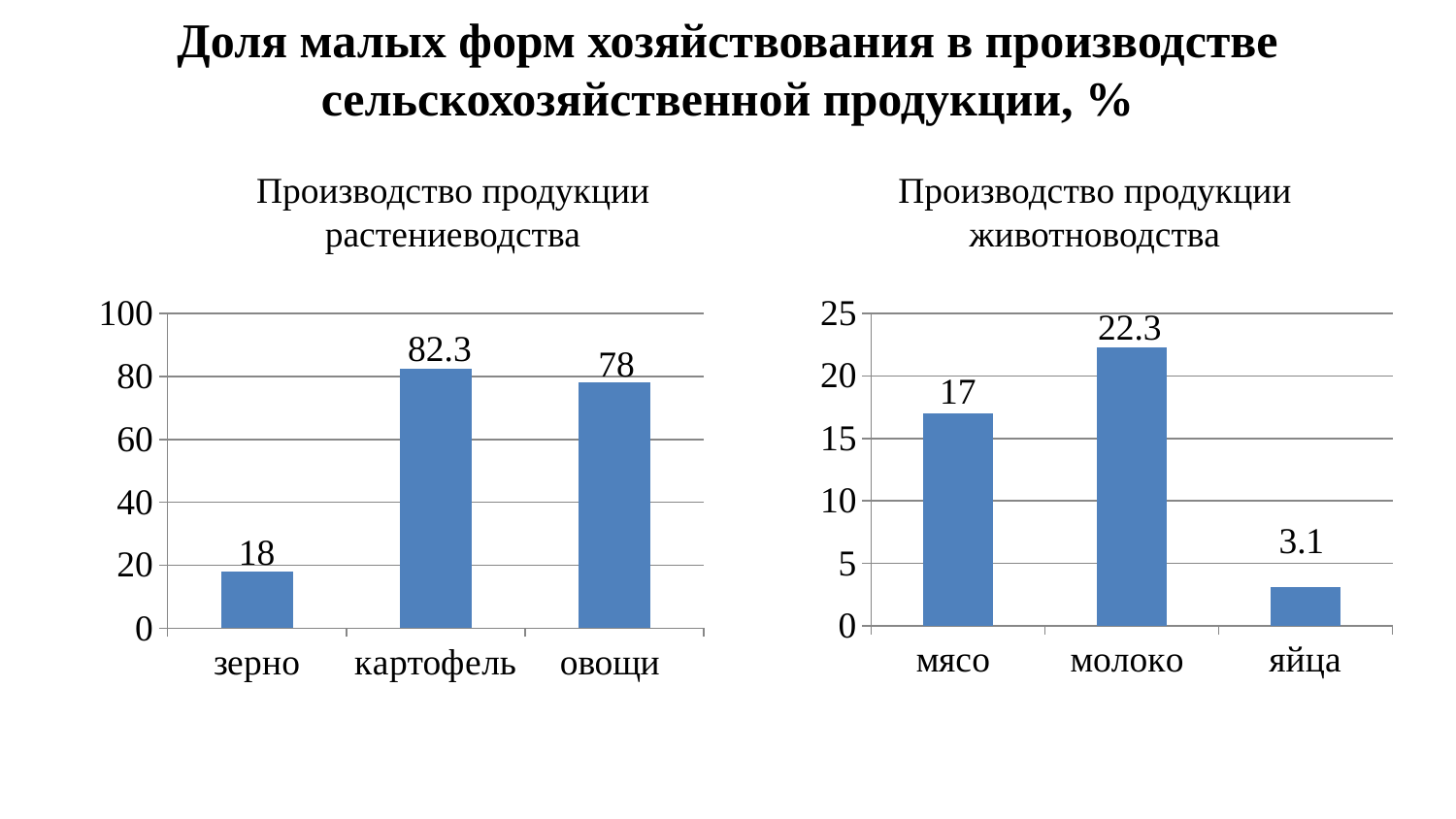
What kind of chart is the chart titled "Производство продукции растениеводства"? bar chart What is the maximum value shown on the vertical axis of the chart titled "Производство продукции животноводства"? 25 In the chart titled "Производство продукции животноводства", which category has the lowest value? яйца In the chart titled "Производство продукции растениеводства", what is the value for зерно? 18 In the chart titled "Производство продукции животноводства", what is the value for яйца? 3.1 How many categories are shown in the chart titled "Производство продукции животноводства"? 3 In the chart titled "Производство продукции растениеводства", what is the value for картофель? 82.3 In the chart titled "Производство продукции растениеводства", which category has the highest value? картофель In the chart titled "Производство продукции животноводства", what is the value for мясо? 17 In the chart titled "Производство продукции растениеводства", what is the difference between the values for картофель and овощи? 4.3 In the chart titled "Производство продукции растениеводства", which is larger, the value for овощи or the value for зерно? овощи In the chart titled "Производство продукции животноводства", what is the difference between the values for молоко and мясо? 5.3